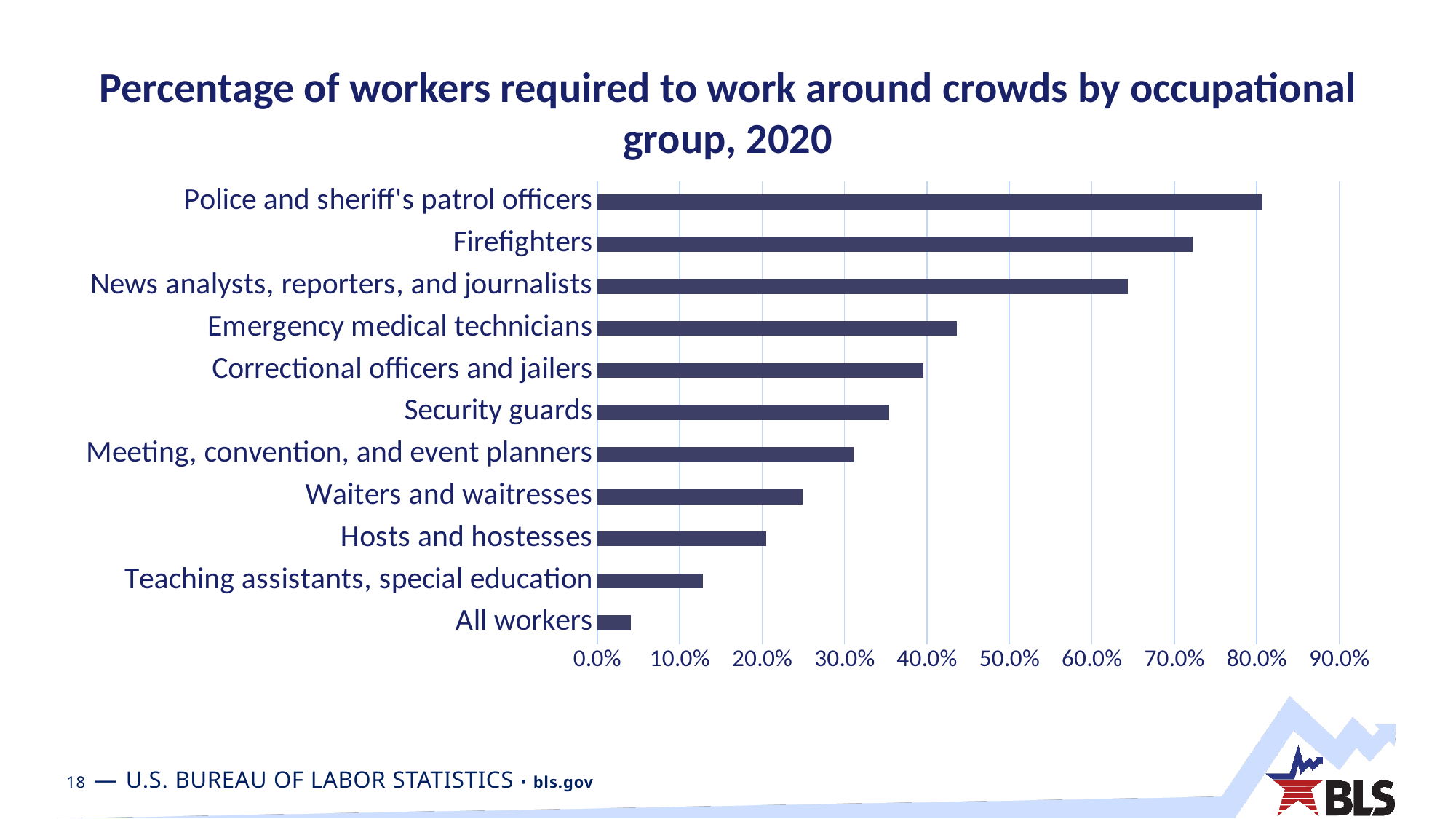
Is the value for Firefighters greater or less than 60.0%? greater Which occupational group has the highest percentage of workers required to work around crowds? Police and sheriff's patrol officers Which has a higher percentage, Security guards or Waiters and waitresses? Security guards What kind of chart is shown on the slide? bar chart Which category has the lowest percentage in the chart? All workers Is the value for Meeting, convention, and event planners greater or less than 40.0%? less Is the value for Emergency medical technicians greater or less than 40.0%? greater Which has a higher percentage, News analysts, reporters, and journalists or Correctional officers and jailers? News analysts, reporters, and journalists What is the title of the chart? Percentage of workers required to work around crowds by occupational group, 2020 How many occupational groups are plotted in the chart? 11